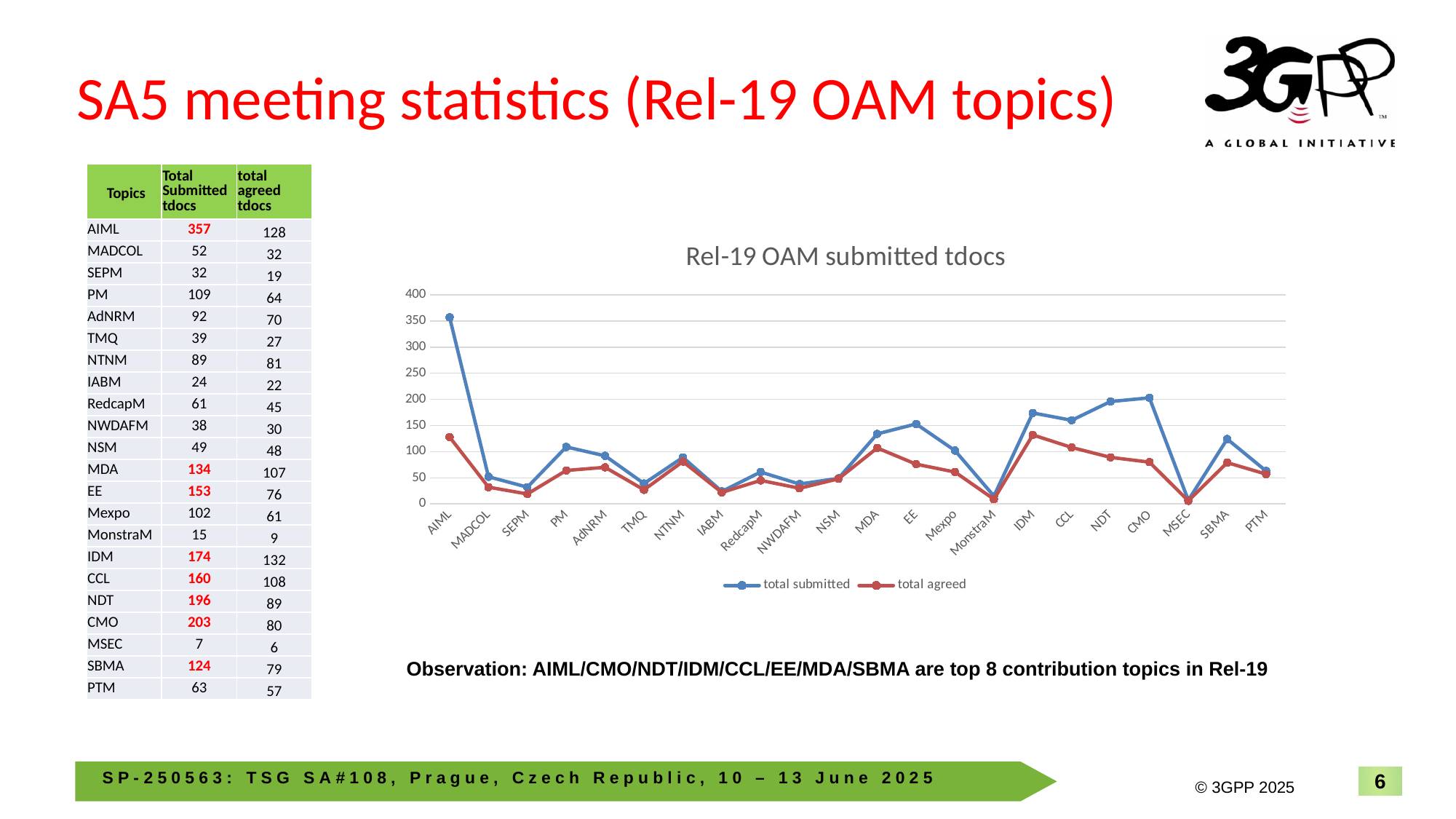
How many series does the chart legend list? 2 What is the title of the chart? Rel-19 OAM submitted tdocs Which topic has the lowest total submitted tdocs? MSEC What type of chart is shown on the slide? line chart Which is larger, total submitted tdocs for IDM or for CCL? IDM What is the difference between total submitted and total agreed tdocs for NDT? 107 Is the total submitted value for AIML greater or less than 300? greater Which topic has the highest total submitted tdocs? AIML How many topics are plotted along the x axis of the chart? 22 What is the total submitted tdocs value for CMO? 203 What is the total agreed tdocs value for AIML? 128 Is the total agreed value for MonstraM greater or less than 50? less